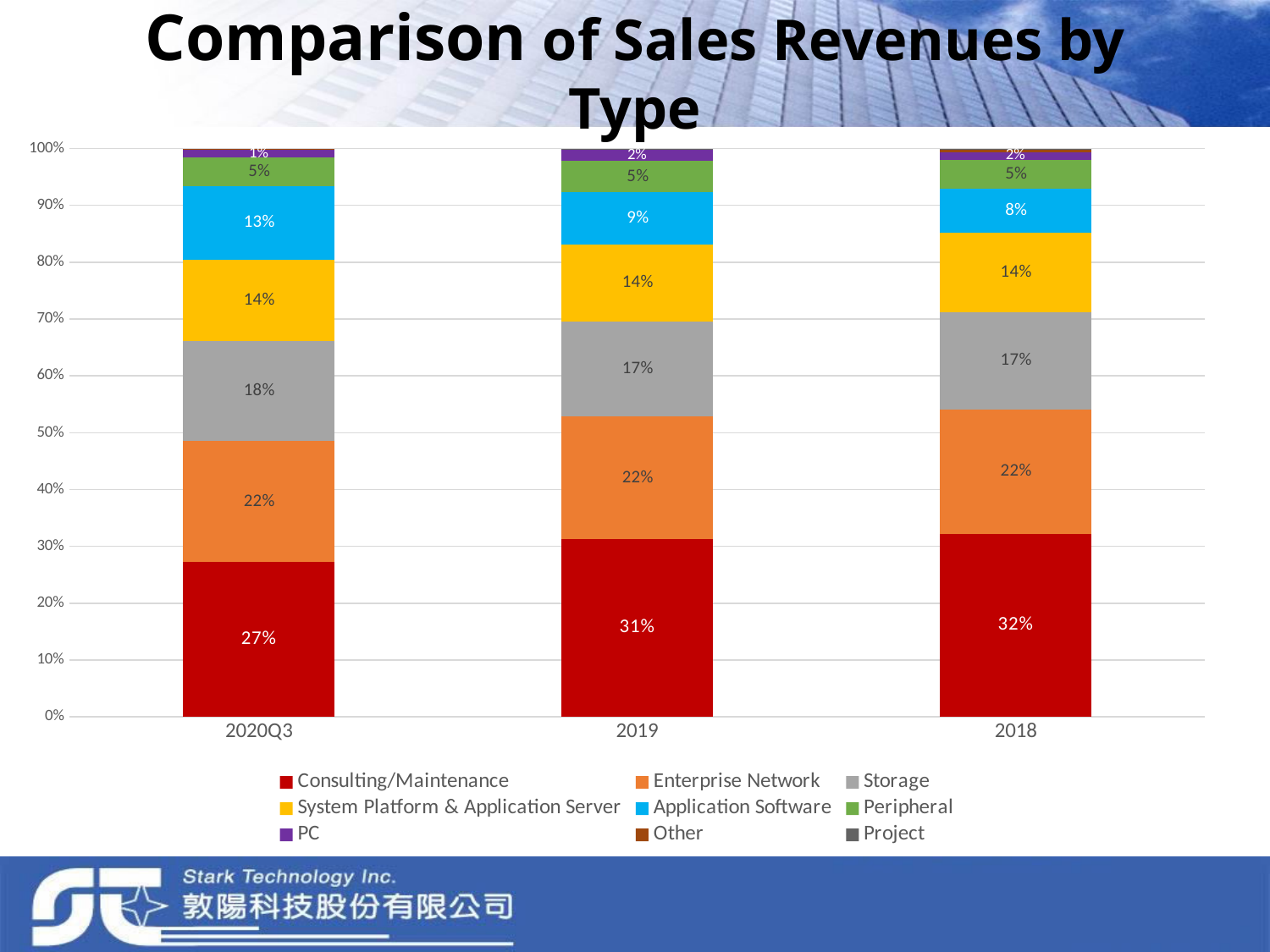
What is the Application Software share for 2019? 9% Which period has the lowest Application Software share? 2018 How many series does the legend list? 9 What is the PC share for 2020Q3? 1% What kind of chart is shown on the slide? Stacked bar chart How many periods are shown on the x axis? 3 What is the Storage share for 2020Q3? 18% What is the Consulting/Maintenance share for 2020Q3? 27% Is the Application Software share larger in 2020Q3 or in 2019? 2020Q3 What is the Consulting/Maintenance share for 2018? 32% What is the difference between the Consulting/Maintenance share in 2018 and in 2020Q3? 5% Which period has the highest Consulting/Maintenance share? 2018